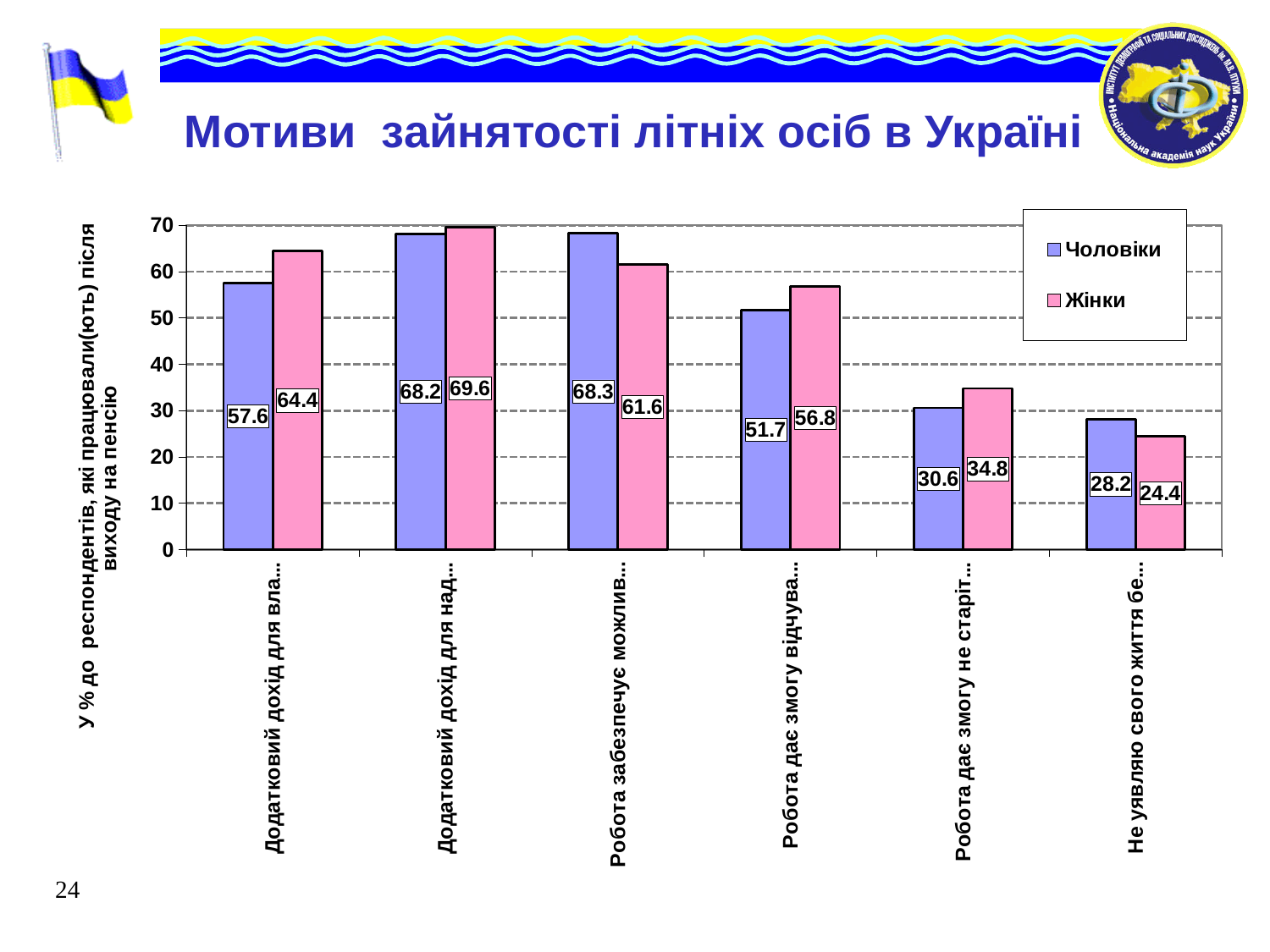
In which category is the value for Жінки the lowest? Не уявляю свого життя бе… In the sixth category ("Не уявляю свого життя бе…"), which series has the larger value, Чоловіки or Жінки? Чоловіки Is the value for Жінки in the third category ("Робота забезпечує можлив…") greater or less than 60? greater What is the value for Жінки in the second category ("Додатковий дохід для над…")? 69.6 In which category is the value for Жінки the highest? Додатковий дохід для над… How many series does the legend list? 2 What type of chart is shown on the slide? bar chart What is the difference between the Жінки and Чоловіки values in the fourth category ("Робота дає змогу відчува…")? 5.1 What are the two series named in the legend? Чоловіки and Жінки What is the value for Чоловіки in the fifth category ("Робота дає змогу не старіт…")? 30.6 How many categories are shown on the x axis? 6 What is the value for Чоловіки in the first category ("Додатковий дохід для вла…")? 57.6